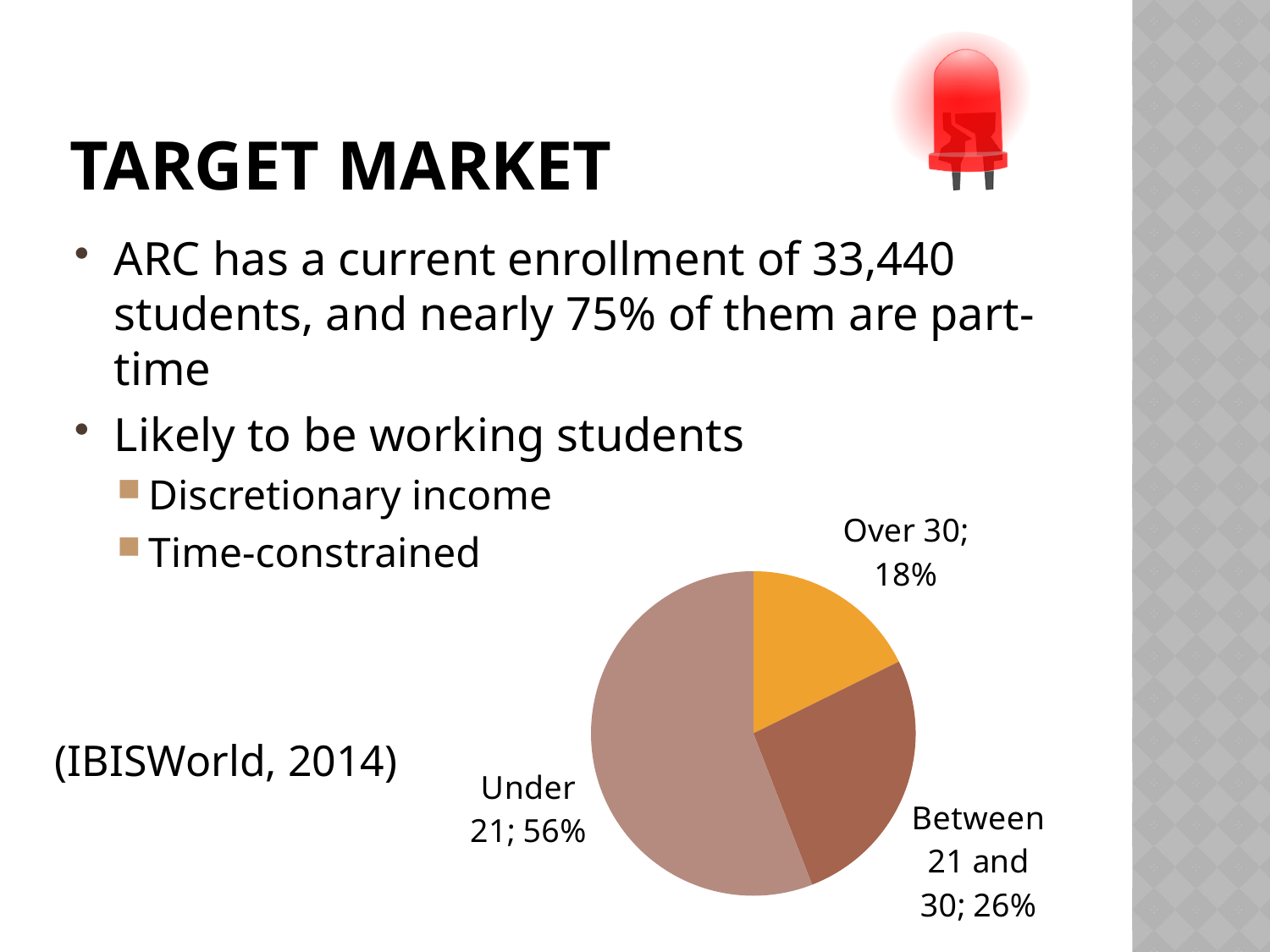
What share of the pie chart is the Over 30 slice? 18% What is the difference in percentage points between the Between 21 and 30 slice and the Over 30 slice? 8 How many slices does the pie chart have? 3 What share of the pie chart is the Under 21 slice? 56% Which slice of the pie chart is the largest? Under 21 What is the combined share of the Under 21 and Between 21 and 30 slices? 82% What share of the pie chart is the Between 21 and 30 slice? 26% What is the difference in percentage points between the Under 21 slice and the Between 21 and 30 slice? 30 Which is larger in the pie chart, the Between 21 and 30 slice or the Over 30 slice? Between 21 and 30 Which slice of the pie chart is the smallest? Over 30 What kind of chart is shown on the slide? Pie chart What colour is the Over 30 slice of the pie chart? Orange